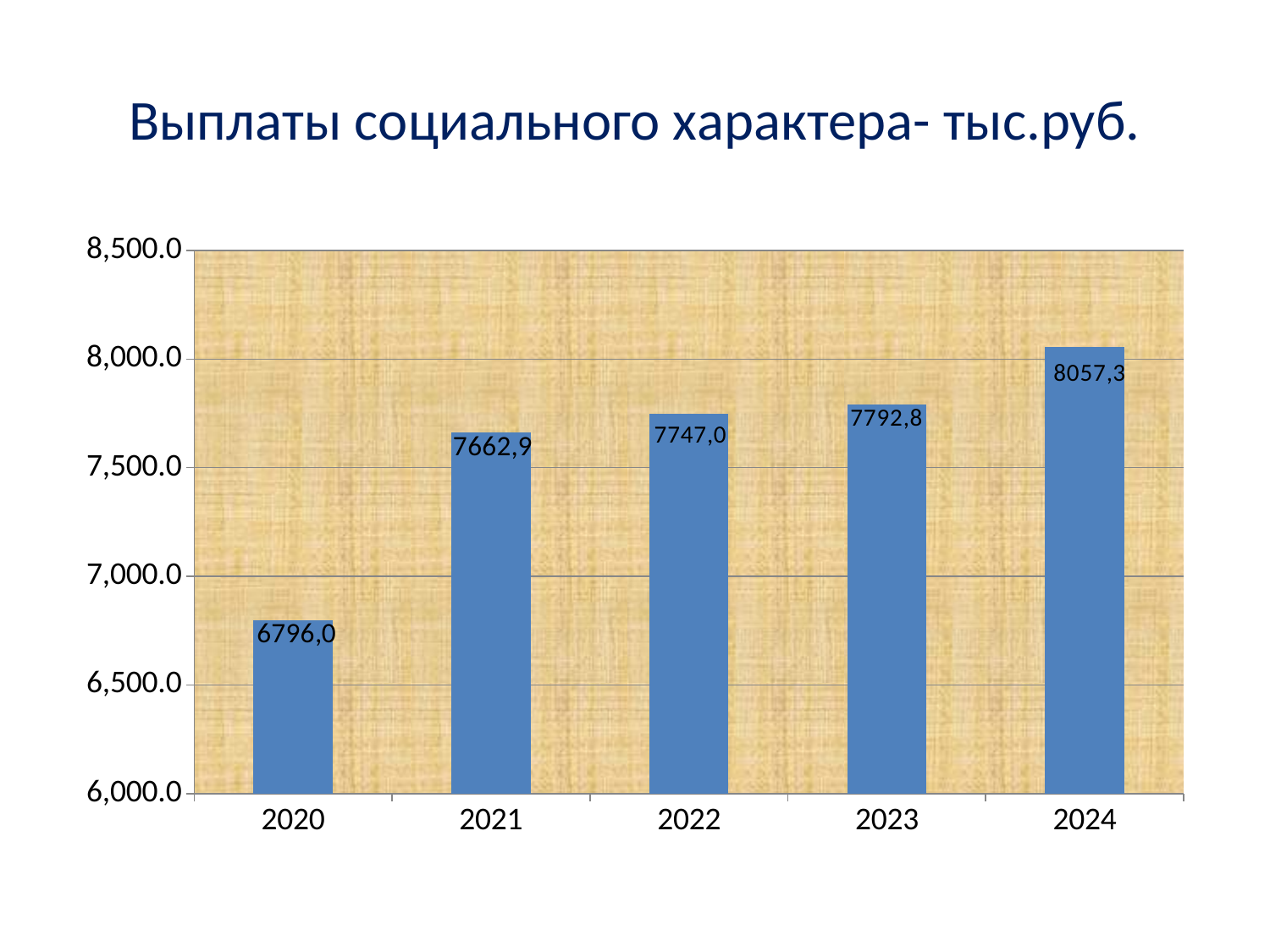
What is the value for 2020? 6796,0 How many years are shown on the x axis? 5 Is the value for 2024 greater or less than 8,000.0? greater What is the difference between the values for 2021 and 2020? 866,9 Which year has the highest value? 2024 Which year has the lowest value? 2020 What is the value for 2022? 7747,0 What is the difference between the values for 2024 and 2020? 1261,3 Do the values rise or fall from 2020 to 2024? rise What kind of chart is shown on the slide? bar chart Which is larger, the value for 2021 or the value for 2023? 2023 What is the value for 2024? 8057,3